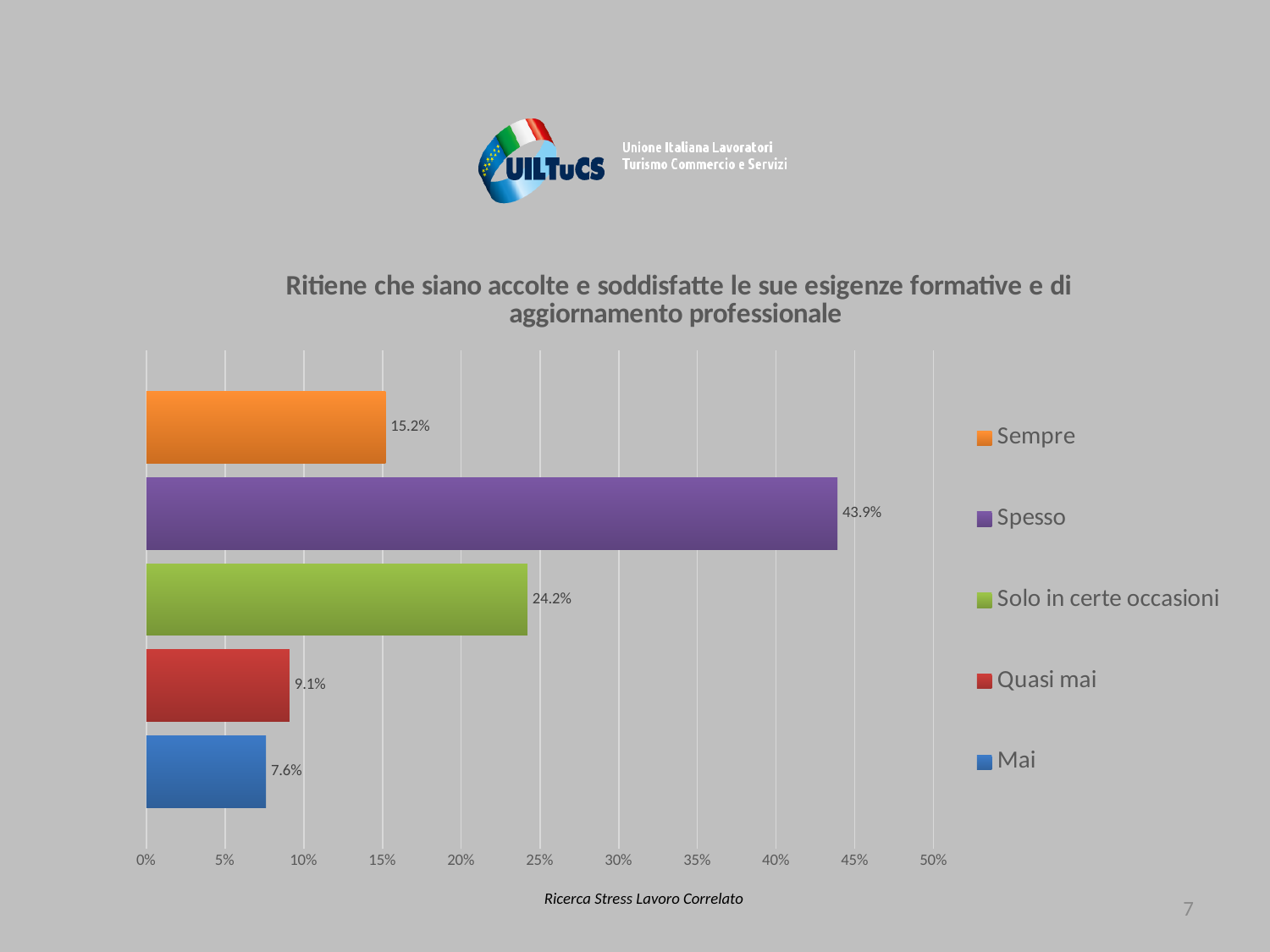
What colour is the bar for Solo in certe occasioni? Green What is the value for Mai? 7.6% Which category has the highest value? Spesso Is the value for Solo in certe occasioni greater or less than 20%? greater What is the value for Spesso? 43.9% What is the value for Sempre? 15.2% What kind of chart is shown on the slide? Bar chart How many categories are shown in the chart? 5 What is the value for Quasi mai? 9.1% Which is larger, the value for Sempre or the value for Quasi mai? Sempre What is the difference between the values for Spesso and Solo in certe occasioni? 19.7% Which category has the lowest value? Mai